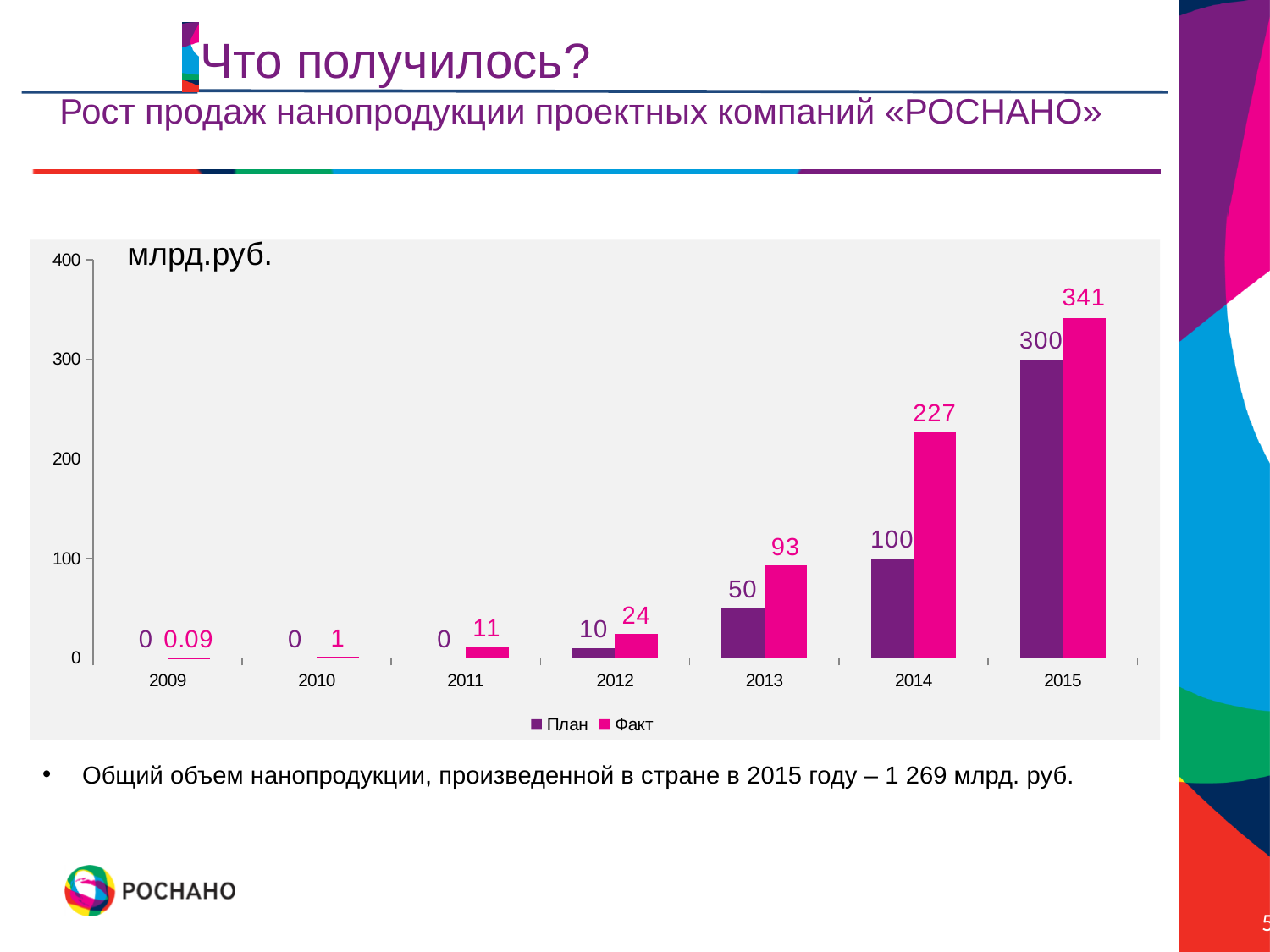
Which year has the highest Факт value? 2015 What is the difference between the Факт and План values for 2013? 43 How many series does the legend list? 2 What is the План value for 2015? 300 How many years are shown on the x axis? 7 Is the Факт value for 2014 greater or less than 200? greater Do the Факт values rise or fall from 2009 to 2015? rise What kind of chart is shown on the slide? bar chart What is the Факт value for 2009? 0.09 Which is larger in 2012, the План value or the Факт value? Факт What unit is shown in the top-left corner of the chart? млрд.руб. What is the Факт value for 2014? 227